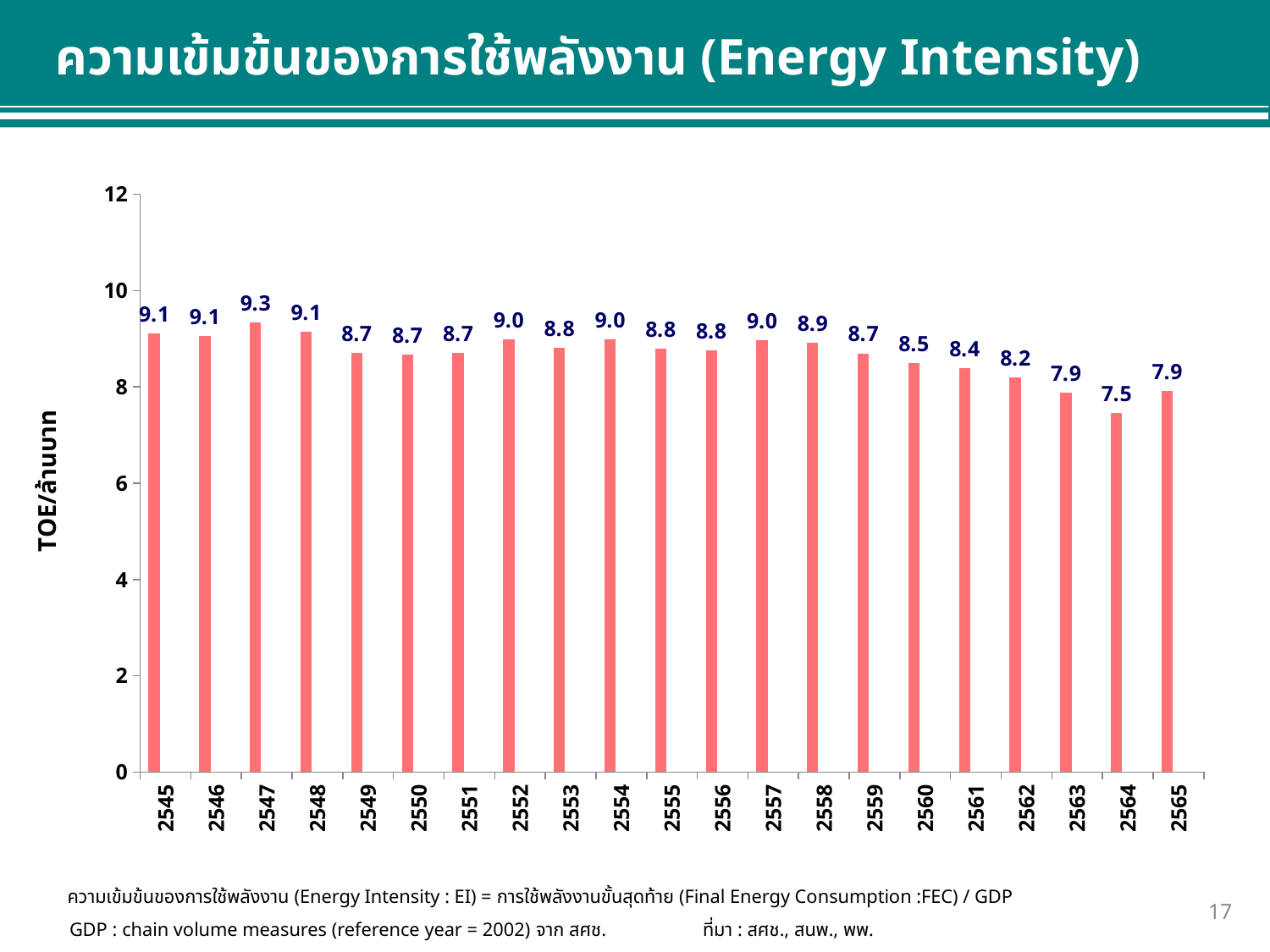
Which year has the highest energy intensity? 2547 Which year has a higher energy intensity, 2552 or 2563? 2552 Is the energy intensity value for 2564 greater or less than 8? less What is the difference between the energy intensity in 2547 and in 2564? 1.8 How many years are shown on the x axis of the chart? 21 What is the energy intensity value for the year 2557? 9.0 Does energy intensity generally rise or fall from 2545 to 2565? fall What is the energy intensity value for the year 2564? 7.5 What is the energy intensity value for the year 2565? 7.9 Which year has the lowest energy intensity? 2564 What kind of chart is shown on the slide? bar chart What is the energy intensity value for the year 2547? 9.3